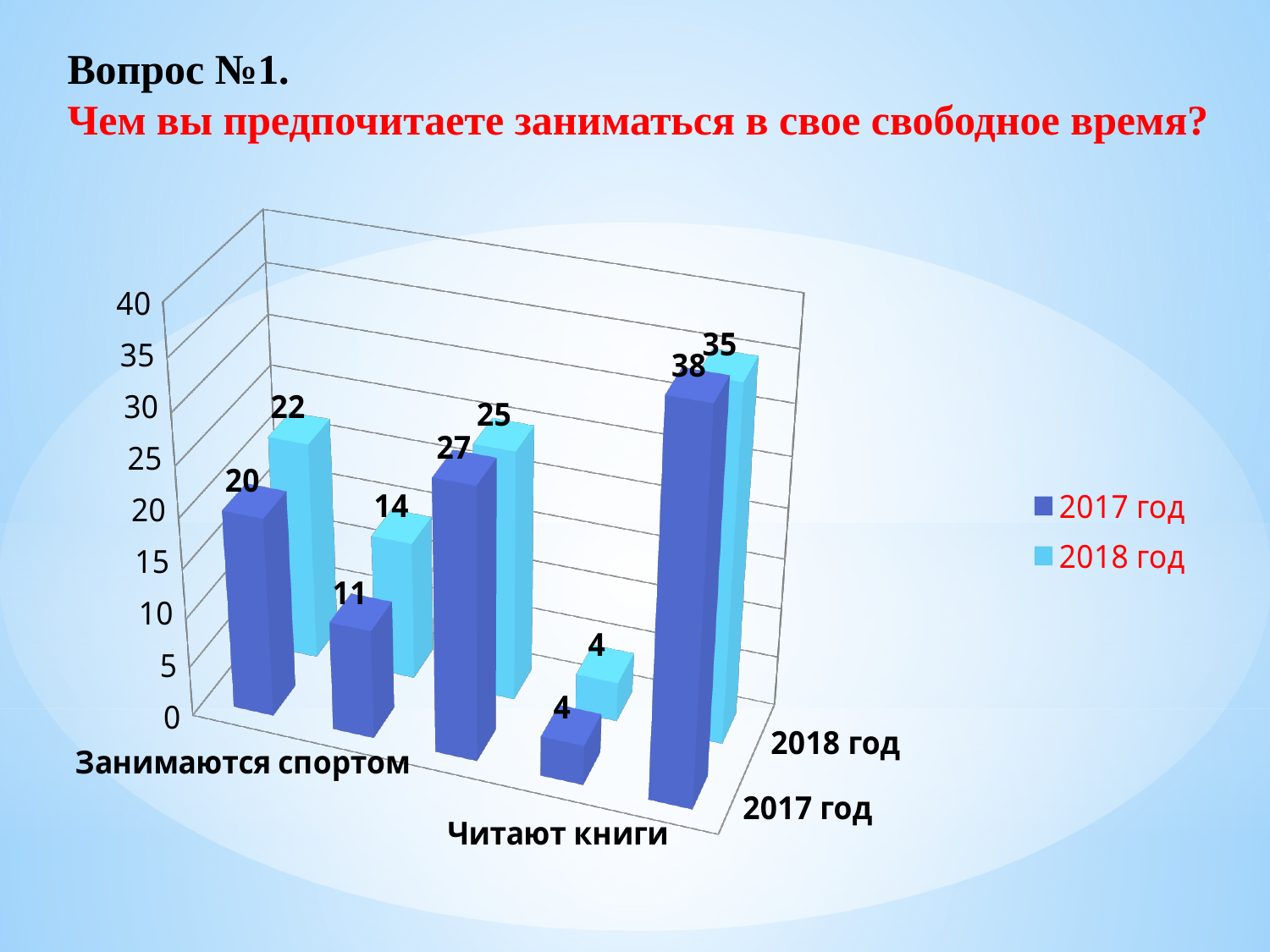
Which series is shown in dark blue according to the legend? 2017 год What is the lowest value shown in the 2017 год series? 4 What is the highest value shown in the 2018 год series? 35 What is the value for Занимаются спортом in the 2018 год series? 22 How many categories (groups of bars) are plotted on the chart? 5 What is the difference between the 2018 год and 2017 год values for Занимаются спортом? 2 What is the value for Занимаются спортом in the 2017 год series? 20 How many series does the legend list? 2 For Занимаются спортом, which series has the larger value, 2017 год or 2018 год? 2018 год Is the value for Занимаются спортом in the 2017 год series greater or less than 25? less What kind of chart is shown on the slide? Bar chart What is the highest value shown in the 2017 год series? 38